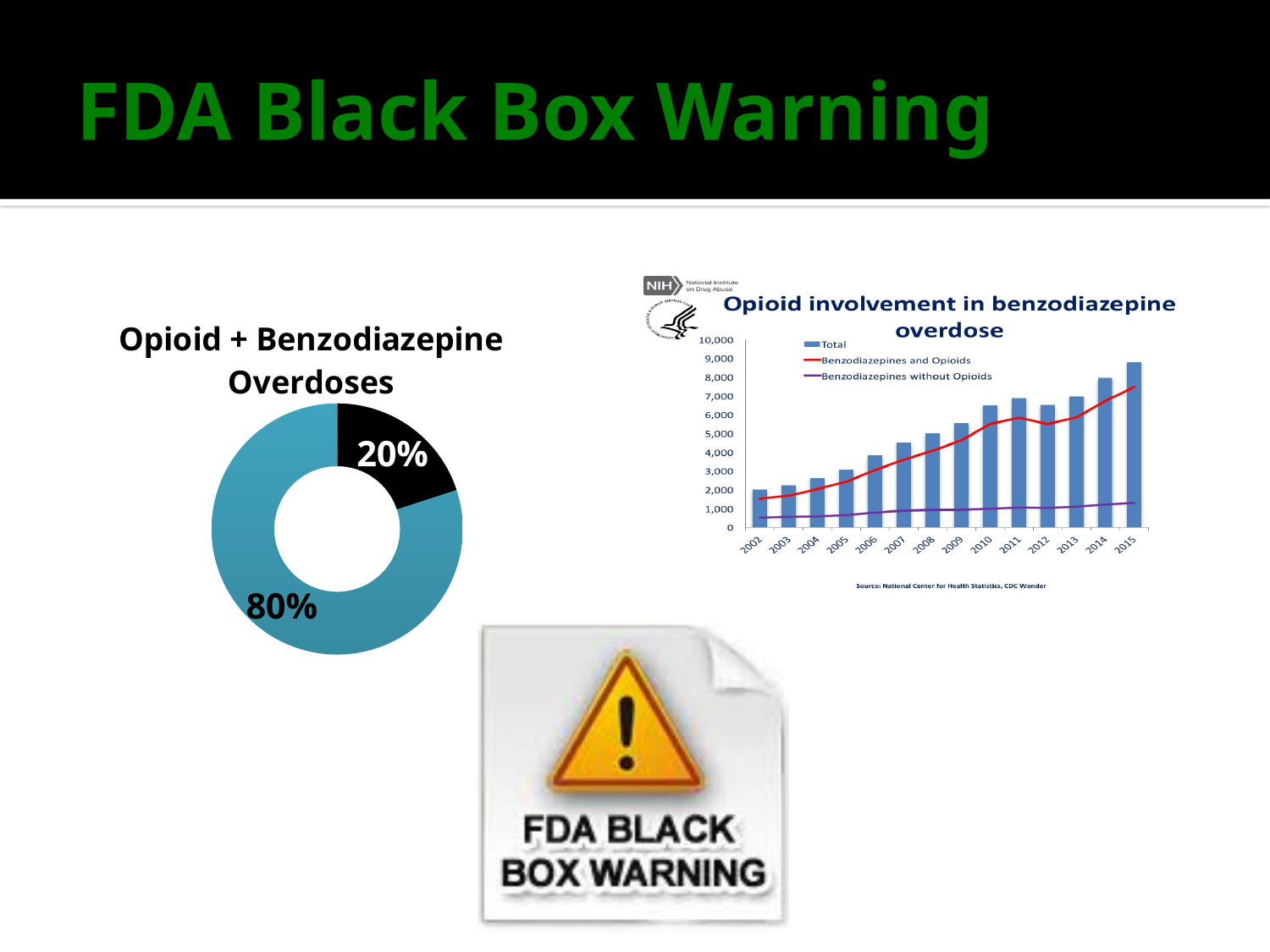
In the 'Opioid + Benzodiazepine Overdoses' chart, what share does the black slice represent? 20% In the 'Opioid involvement in benzodiazepine overdose' chart, is the Total for 2002 greater or less than 3,000? less In the 'Opioid + Benzodiazepine Overdoses' chart, how many slices are there? 2 In the 'Opioid + Benzodiazepine Overdoses' chart, what share does the teal slice represent? 80% In the 'Opioid involvement in benzodiazepine overdose' chart, does the Total generally rise or fall from 2002 to 2015? Rise In the 'Opioid + Benzodiazepine Overdoses' chart, which slice is larger, the black one or the teal one? The teal one (80%) What kind of chart is the 'Opioid + Benzodiazepine Overdoses' chart on the left? Donut (pie) chart In the 'Opioid involvement in benzodiazepine overdose' chart, how many years are shown on the x axis? 14 In the 'Opioid involvement in benzodiazepine overdose' chart, how many series does the legend list? 3 In the 'Opioid involvement in benzodiazepine overdose' chart, which year has the highest Total bar? 2015 In the 'Opioid involvement in benzodiazepine overdose' chart, is the Total for 2015 greater or less than 8,000? greater In the 'Opioid involvement in benzodiazepine overdose' chart, which year has the lowest Total bar? 2002